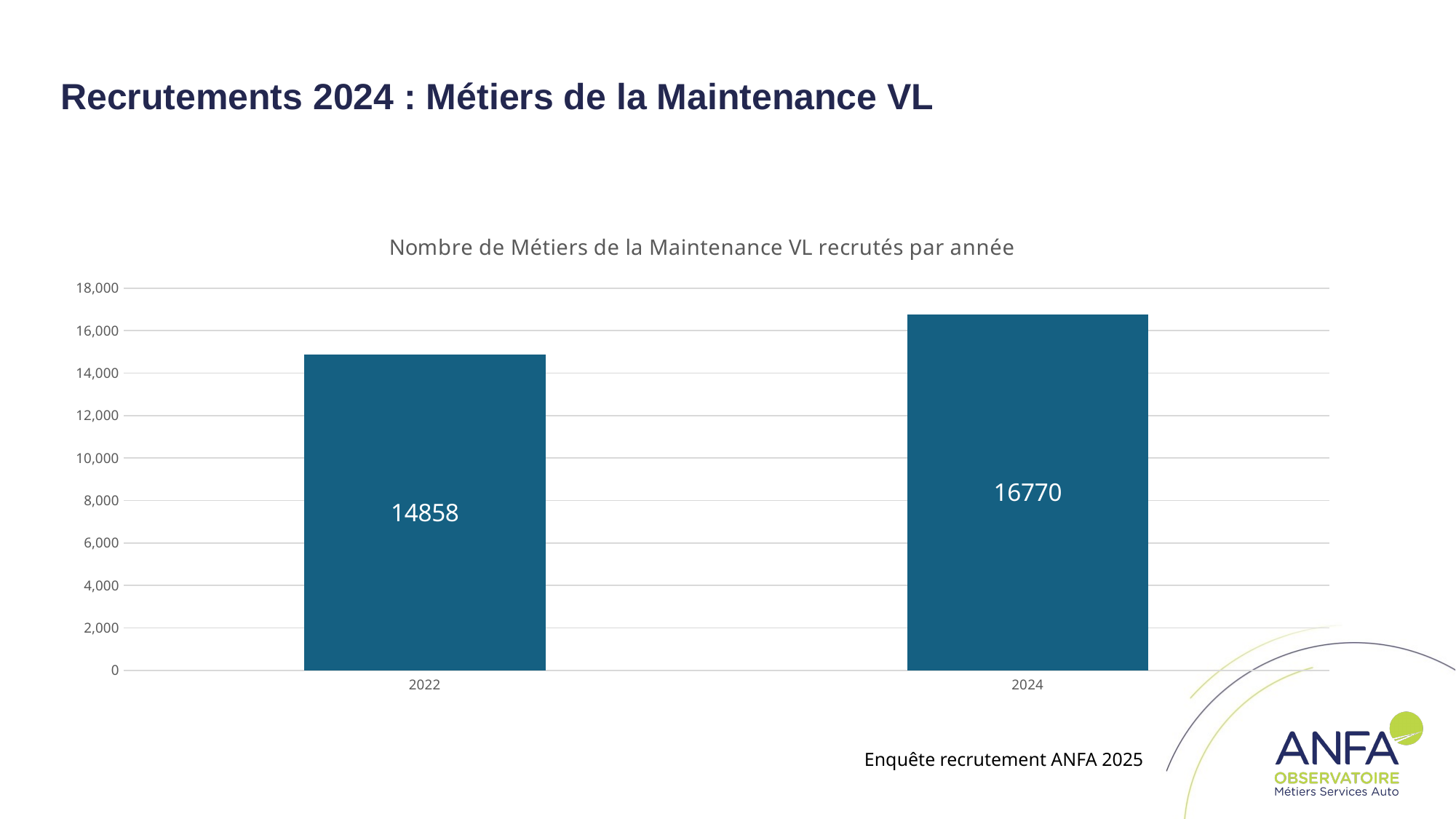
Do the values rise or fall from 2022 to 2024? rise Is the value for 2022 greater or less than 16,000? less Is the value for 2024 greater or less than 16,000? greater Which is larger, the value for 2022 or the value for 2024? 2024 What is the value for 2022? 14858 Which year has the lowest value? 2022 What is the value for 2024? 16770 What is the title of the chart? Nombre de Métiers de la Maintenance VL recrutés par année Which year has the highest value? 2024 How many years are shown on the x axis? 2 What kind of chart is shown on the slide? bar chart What is the difference between the values for 2024 and 2022? 1912